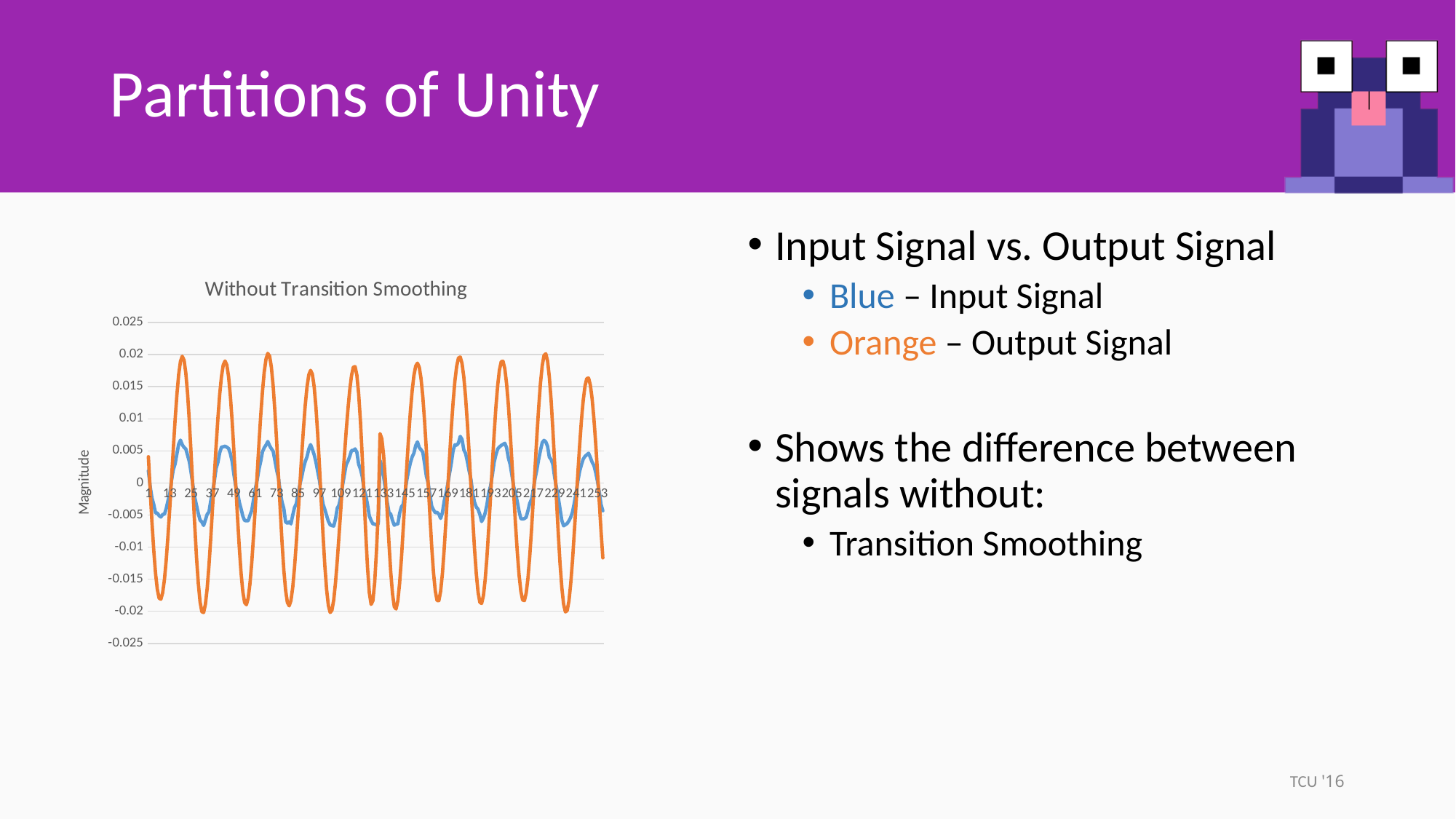
What is the title of the chart? Without Transition Smoothing What kind of chart is shown on the slide? line chart Are the lowest values of the orange line greater or less than -0.015? less What is the highest value shown on the vertical axis? 0.025 What is the lowest value shown on the vertical axis? -0.025 What is the last tick label on the horizontal axis? 253 How many lines (series) are plotted on the chart? 2 Are the peak values of the blue line greater or less than 0.01? less Are the lowest values of the blue line greater or less than -0.01? greater Which line reaches larger peak values, the blue line or the orange line? orange What is the label on the vertical axis of the chart? Magnitude